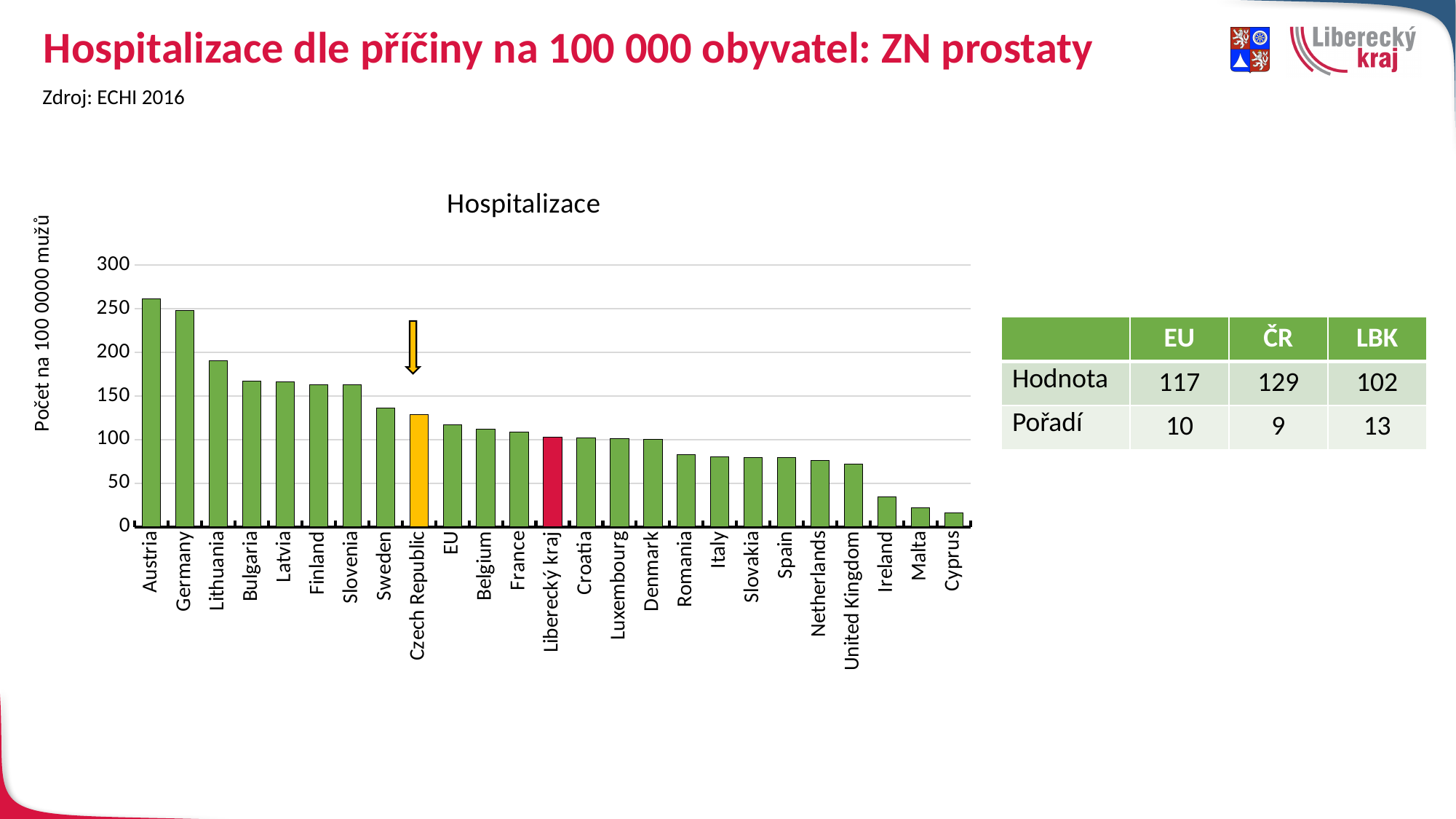
What is the hospitalization value for the Czech Republic? 129 Is the value for Ireland greater or less than 50? less Do the values rise or fall from left to right along the x axis? fall What is the hospitalization value for Liberecký kraj? 102 How many categories (bars) are plotted in the chart? 25 Which country has the lowest hospitalization value in the chart? Cyprus Is the value for Austria greater or less than 200? greater What kind of chart is shown on the slide? bar chart What is the hospitalization value for the EU? 117 Which country has the highest hospitalization value in the chart? Austria What is the difference between the values for the Czech Republic and Liberecký kraj? 27 Which is larger, the value for Germany or the value for Lithuania? Germany